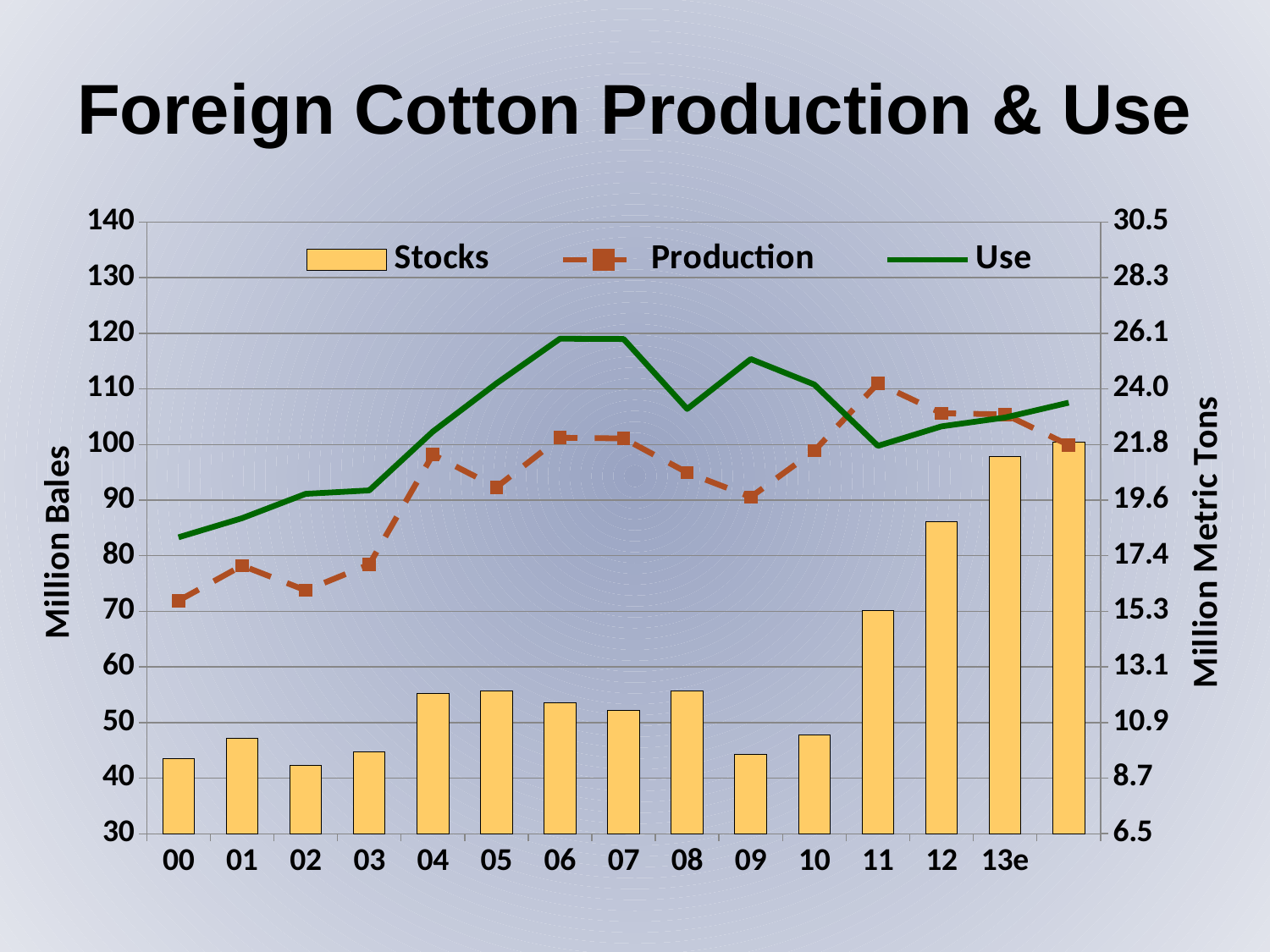
In which year is the Production line at its highest? 11 In which year is the Use line at its lowest? 00 Is the Use value for 06 greater or less than 110 on the left axis? greater What is the title of the left vertical axis? Million Bales How do the Stocks bars change from 10 through 13e? They rise Is the Stocks value for 12 greater or less than 80 million bales? greater How many series does the legend list? 3 In which year is the Production line at its lowest? 00 What kind of chart is shown on the slide? A combination bar and line chart In 11, which is higher, Production or Use? Production Which series is drawn as bars? Stocks Is the Stocks value for 09 greater or less than 50 million bales? less